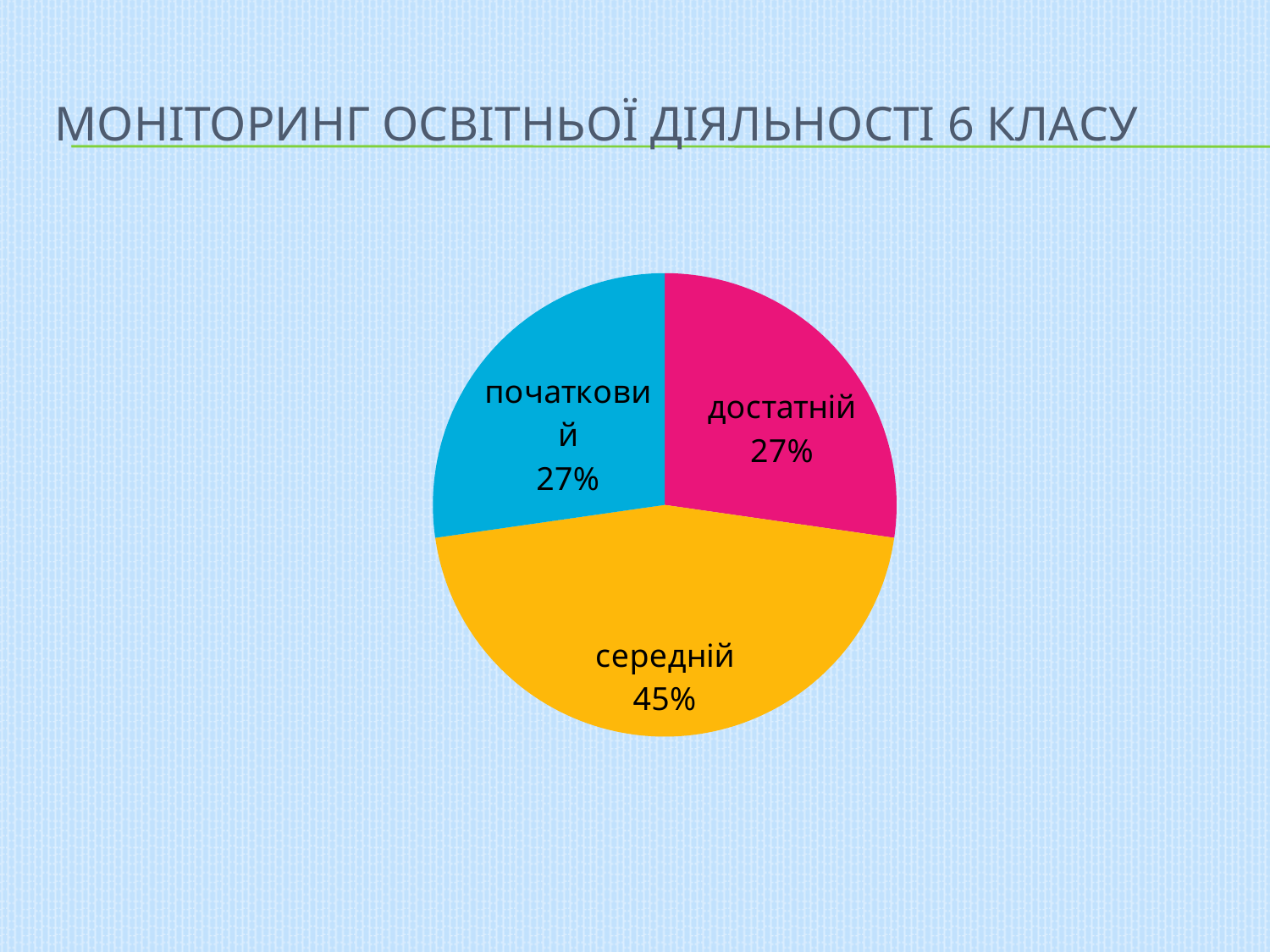
What kind of chart is shown on the slide? pie chart What share of the pie does the "середній" slice represent? 45% What is the difference in percentage points between the "середній" and "достатній" slices? 18 Is the value for "середній" greater or less than 40%? greater How many slices does the pie chart have? 3 What colour is the "середній" slice? yellow Which is larger, the "середній" slice or the "початковий" slice? середній What is the title of the slide containing the chart? МОНІТОРИНГ ОСВІТНЬОЇ ДІЯЛЬНОСТІ 6 КЛАСУ What share of the pie does the "початковий" slice represent? 27% What share of the pie does the "достатній" slice represent? 27% Which category has the largest slice of the pie? середній